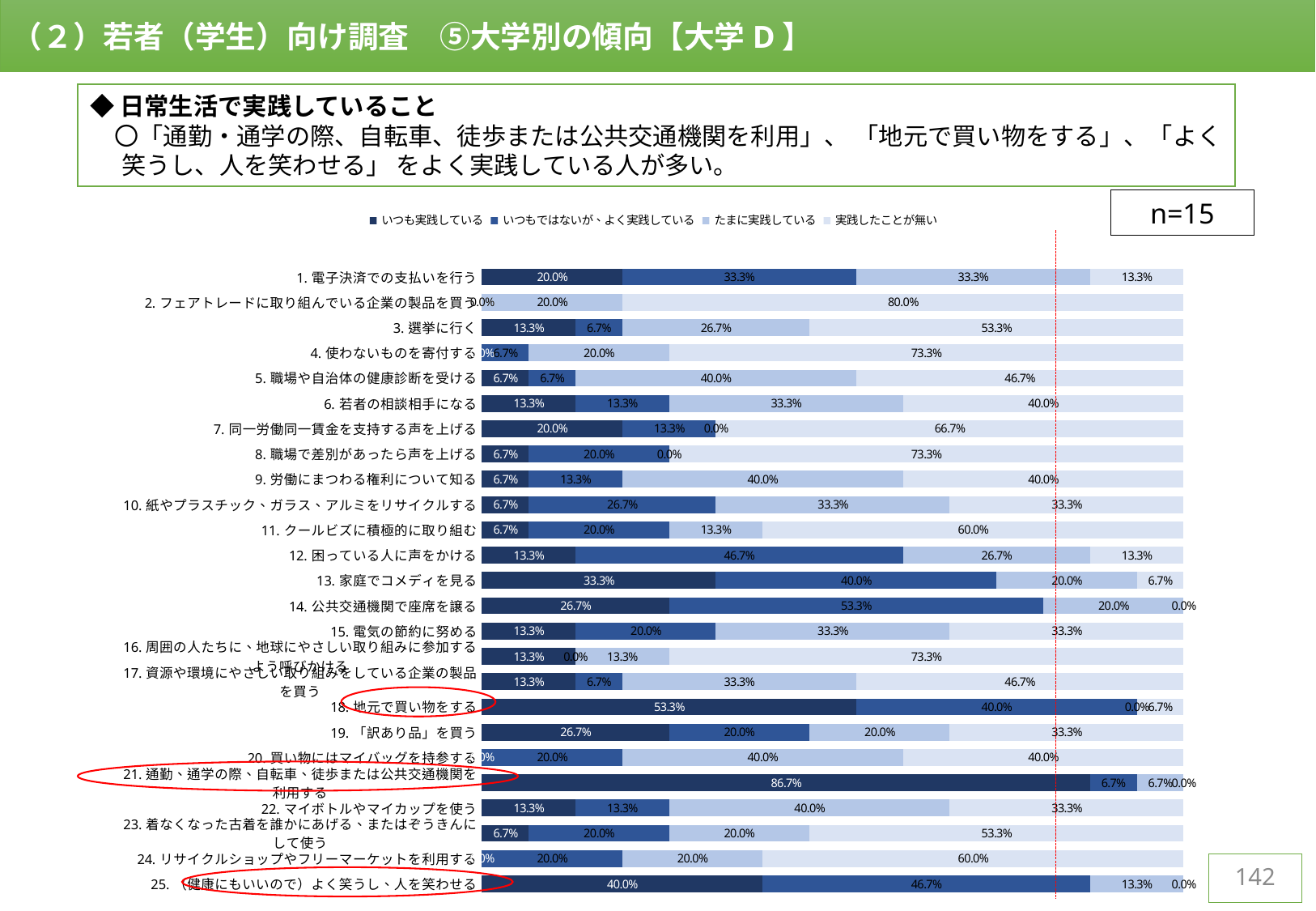
What is the value of 「いつも実践している」 for item 18 「地元で買い物をする」? 53.3% Which item has the highest value for 「いつも実践している」? 21. 通勤、通学の際、自転車、徒歩または公共交通機関を利用する What is the value of 「いつもではないが、よく実践している」 for item 25 「（健康にもいいので）よく笑うし、人を笑わせる」? 46.7% What kind of chart is shown on the slide? Stacked bar chart How many series does the legend list? 4 How many categories (items) are plotted in the chart? 25 What is the value of 「たまに実践している」 for item 1 「電子決済での支払いを行う」? 33.3% What is the value of 「実践したことが無い」 for item 2 「フェアトレードに取り組んでいる企業の製品を買う」? 80.0% Which is larger: the 「実践したことが無い」 value for item 4 「使わないものを寄付する」 or for item 3 「選挙に行く」? 4. 使わないものを寄付する What is the difference between the 「いつも実践している」 values for item 18 「地元で買い物をする」 and item 25 「よく笑うし、人を笑わせる」? 13.3% What is the value of 「いつも実践している」 for item 21 「通勤、通学の際、自転車、徒歩または公共交通機関を利用する」? 86.7% What is the sample size (n) shown on the slide? n=15